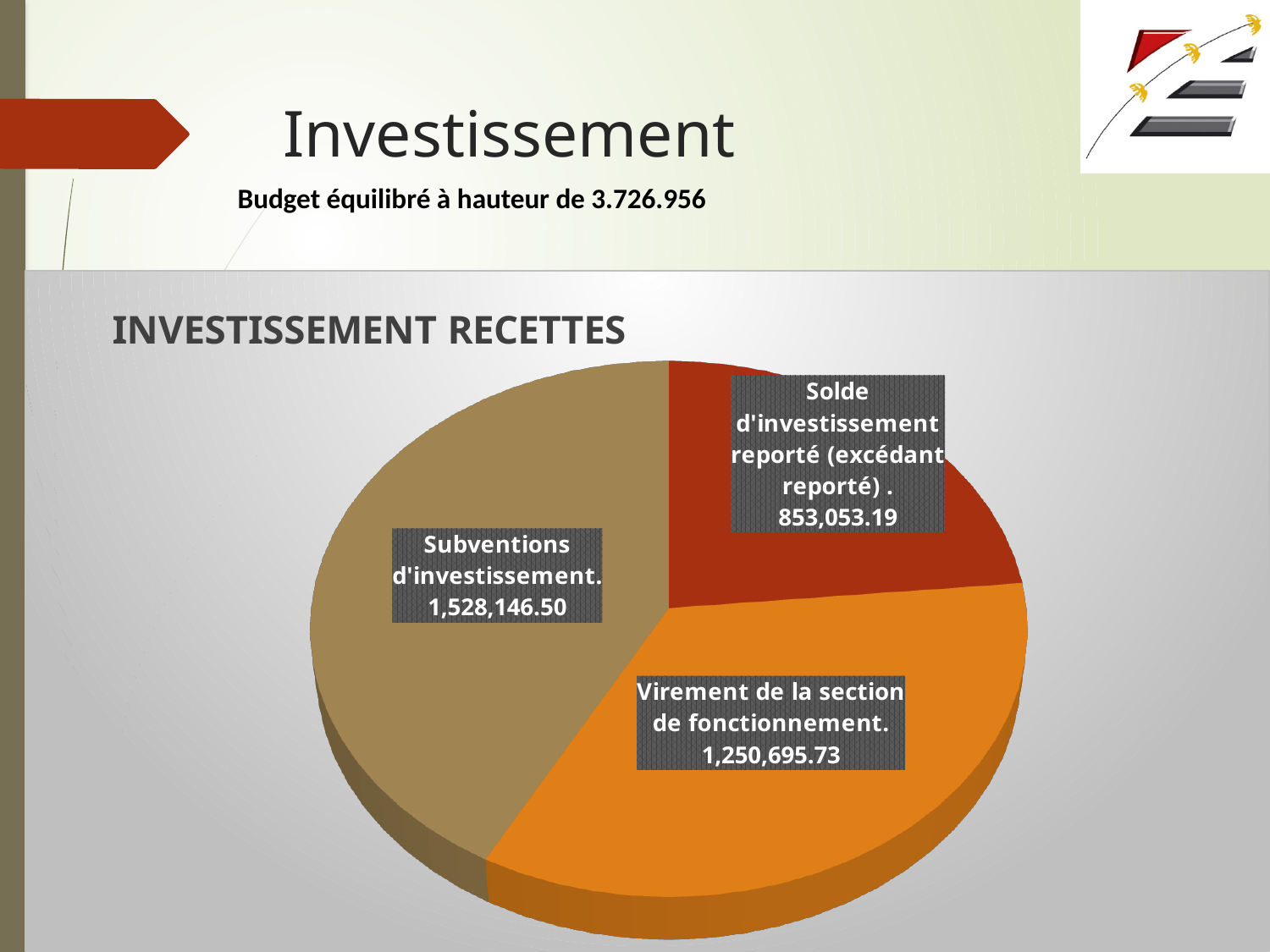
Which category has the largest slice of the pie? Subventions d'investissement What is the difference between Subventions d'investissement and Virement de la section de fonctionnement? 277,450.77 What is the title of the chart? INVESTISSEMENT RECETTES What is the value for Virement de la section de fonctionnement? 1,250,695.73 What is the value for Solde d'investissement reporté (excédant reporté)? 853,053.19 Which category has the smallest slice of the pie? Solde d'investissement reporté (excédant reporté) What colour is the Virement de la section de fonctionnement slice? Orange What type of chart is shown on the slide? Pie chart How many slices does the pie chart have? 3 What is the value for Subventions d'investissement? 1,528,146.50 What is the difference between Virement de la section de fonctionnement and Solde d'investissement reporté? 397,642.54 Which is larger: Virement de la section de fonctionnement or Solde d'investissement reporté? Virement de la section de fonctionnement